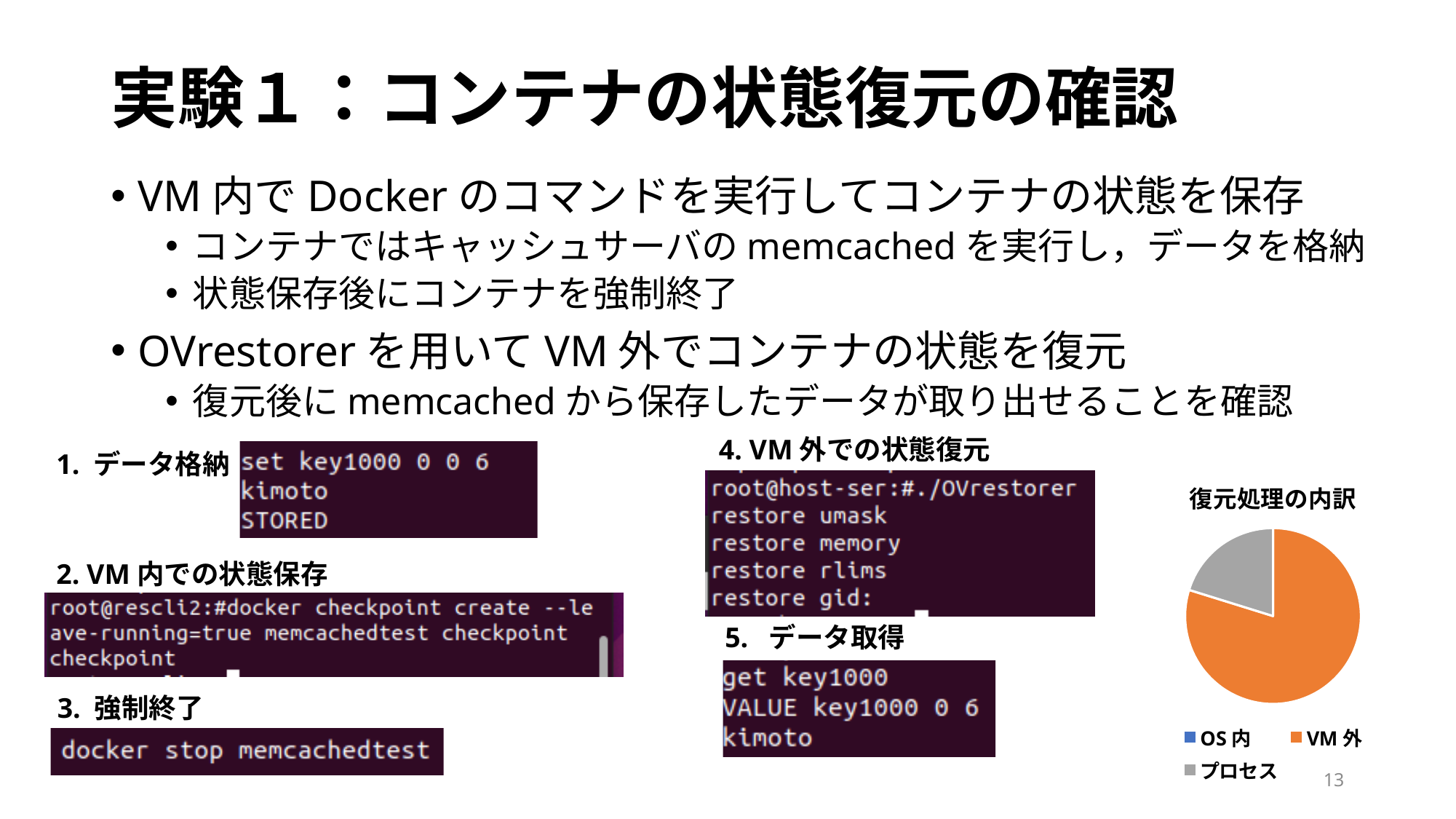
In the pie chart, which slice is larger: VM 外 or プロセス? VM 外 What is the title of the pie chart? 復元処理の内訳 What colour represents VM 外 in the pie chart? orange In the pie chart, which slice is larger: プロセス or OS 内? プロセス What kind of chart is shown on the slide? pie chart How many categories does the legend of the pie chart list? 3 Which category in the pie chart is shown in gray? プロセス Which category has the largest slice in the pie chart? VM 外 Which category has the smallest slice in the pie chart? OS 内